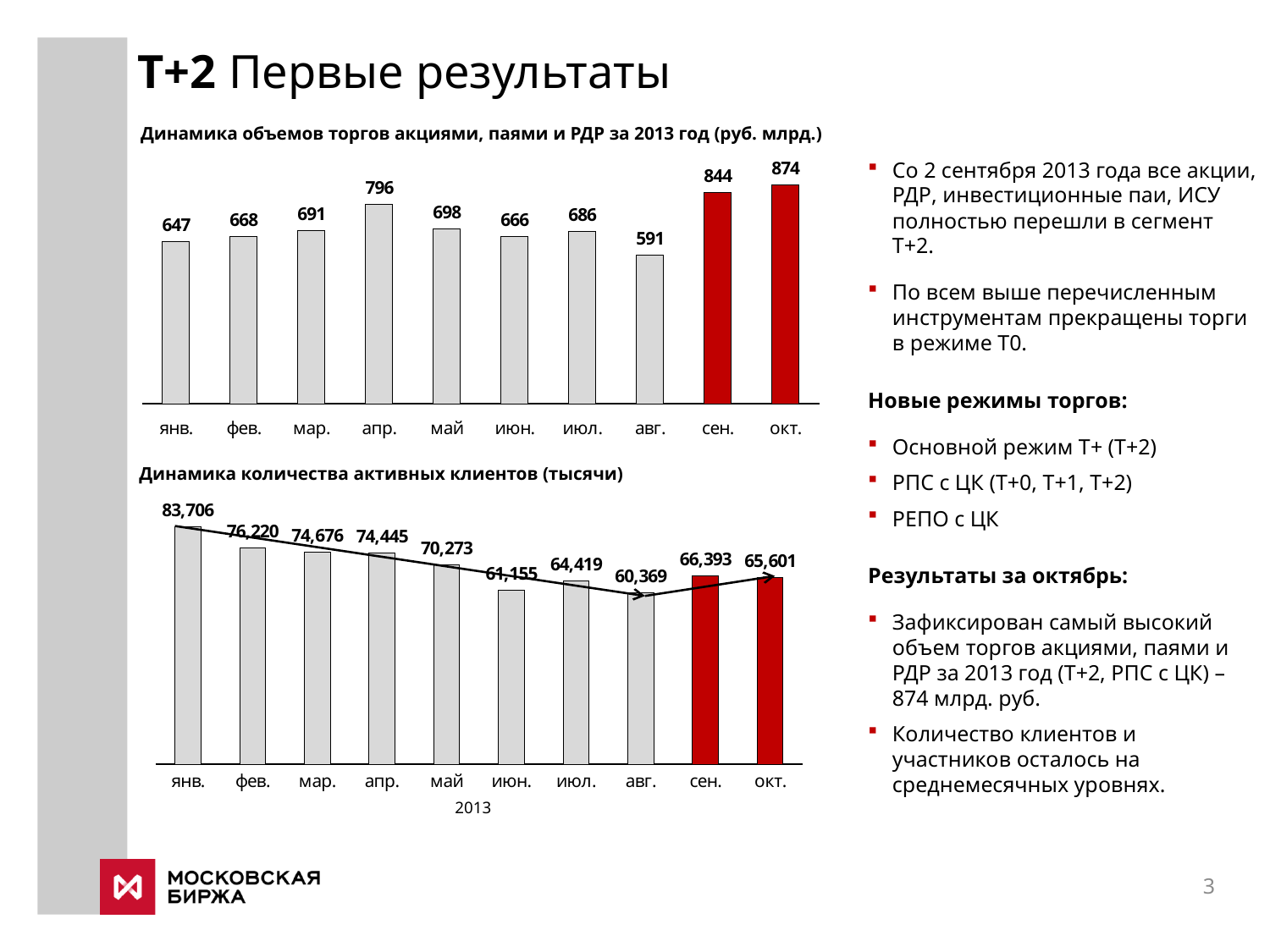
In the bottom chart (Динамика количества активных клиентов), which month has the lowest value? авг. In the bottom chart (Динамика количества активных клиентов), what is the value for янв.? 83,706 What type of chart is the top chart (Динамика объемов торгов акциями, паями и РДР за 2013 год)? bar chart In the top chart (Динамика объемов торгов акциями, паями и РДР за 2013 год), how many months are plotted? 10 In the bottom chart (Динамика количества активных клиентов), what is the value for окт.? 65,601 In the bottom chart (Динамика количества активных клиентов), what is the difference between the values for сен. and окт.? 792 In the top chart (Динамика объемов торгов акциями, паями и РДР за 2013 год), what is the difference between the values for окт. and сен.? 30 In the top chart (Динамика объемов торгов акциями, паями и РДР за 2013 год), which month has the highest value? окт. In the top chart (Динамика объемов торгов акциями, паями и РДР за 2013 год), which month has the lowest value? авг. In the top chart (Динамика объемов торгов акциями, паями и РДР за 2013 год), what is the value for апр.? 796 In the bottom chart (Динамика количества активных клиентов), do the values generally rise or fall from янв. to авг.? fall In the bottom chart (Динамика количества активных клиентов), which is larger, the value for июн. or the value for июл.? июл.